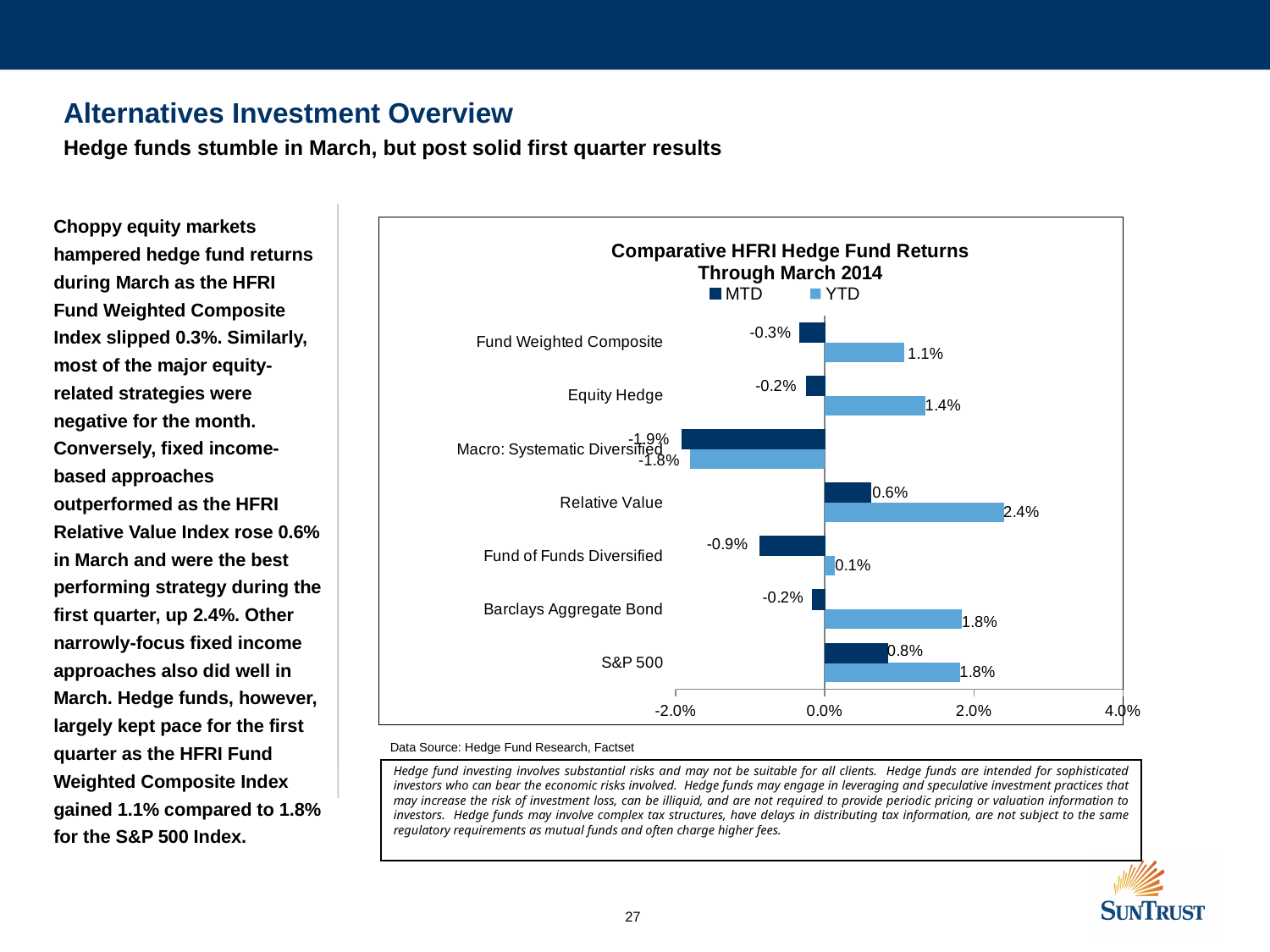
What is the title of the chart? Comparative HFRI Hedge Fund Returns Through March 2014 What is the YTD return for Relative Value? 2.4% What is the MTD return for Macro: Systematic Diversified? -1.9% How many series does the legend list? 2 What is the difference between the YTD returns of the S&P 500 and the Fund Weighted Composite? 0.7% What is the MTD return for Fund Weighted Composite? -0.3% What kind of chart is shown on the slide? Bar chart How many categories are shown on the chart? 7 Which category has the lowest MTD return? Macro: Systematic Diversified What is the YTD return for Barclays Aggregate Bond? 1.8% Which is larger, the YTD return for Equity Hedge or the YTD return for Fund of Funds Diversified? Equity Hedge Which category has the highest YTD return? Relative Value